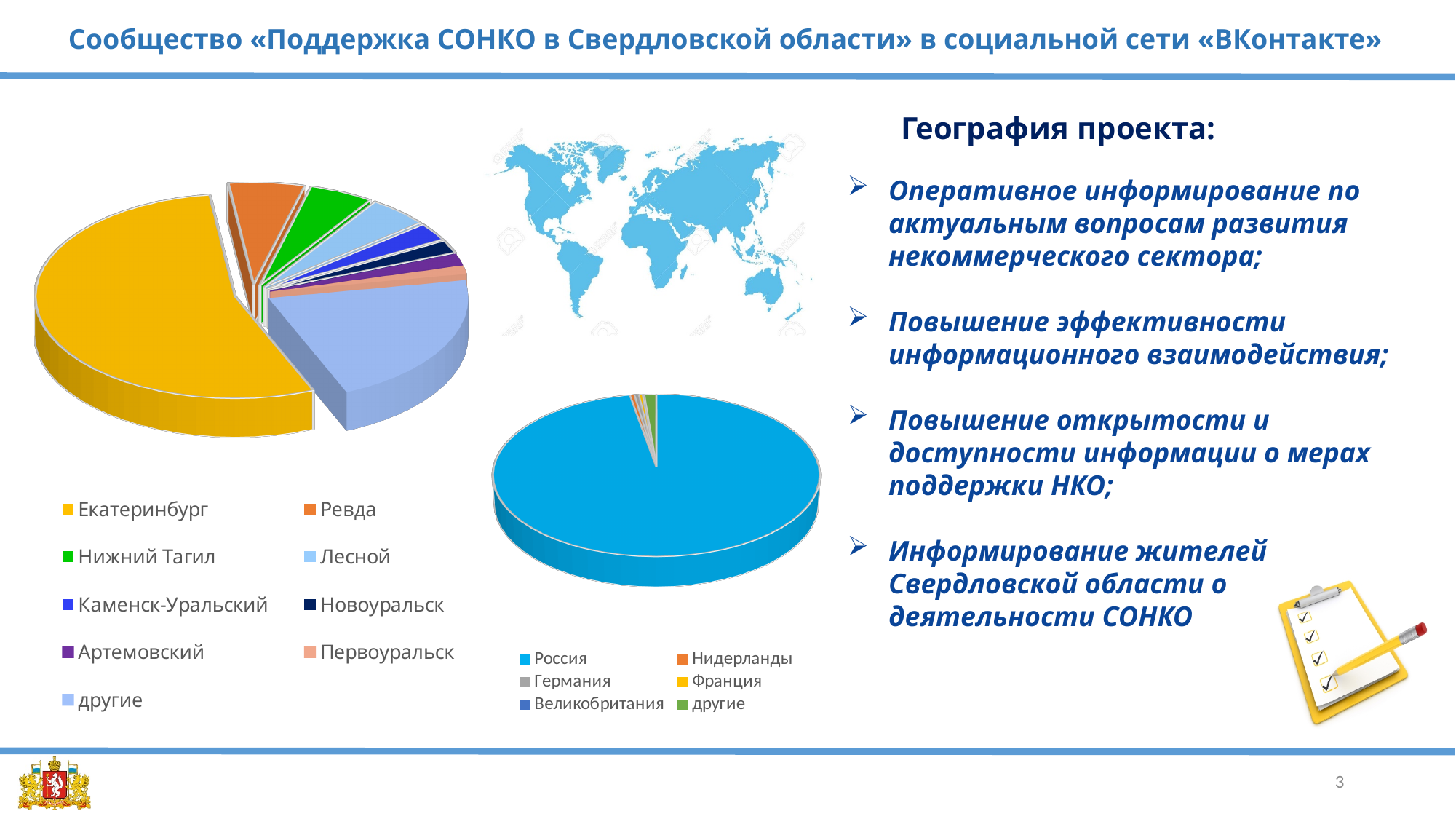
What kind of chart is the right chart (the one with Россия in its legend)? pie chart How many categories does the legend of the right pie chart (countries) list? 6 In the right pie chart (countries), what colour is the Россия slice? blue In the right pie chart (countries), which slice is larger: Россия or Германия? Россия In the left pie chart (cities), what colour is the Екатеринбург slice? yellow In the left pie chart (cities), which category has the largest slice? Екатеринбург In the right pie chart (countries), which category has the largest slice? Россия How many categories does the legend of the left pie chart (cities) list? 9 In the left pie chart (cities), which category is the second largest slice? другие What kind of chart is the left chart (the one with Екатеринбург in its legend)? pie chart In the left pie chart (cities), which slice is larger: другие or Ревда? другие In the left pie chart (cities), which slice is larger: Екатеринбург or Ревда? Екатеринбург